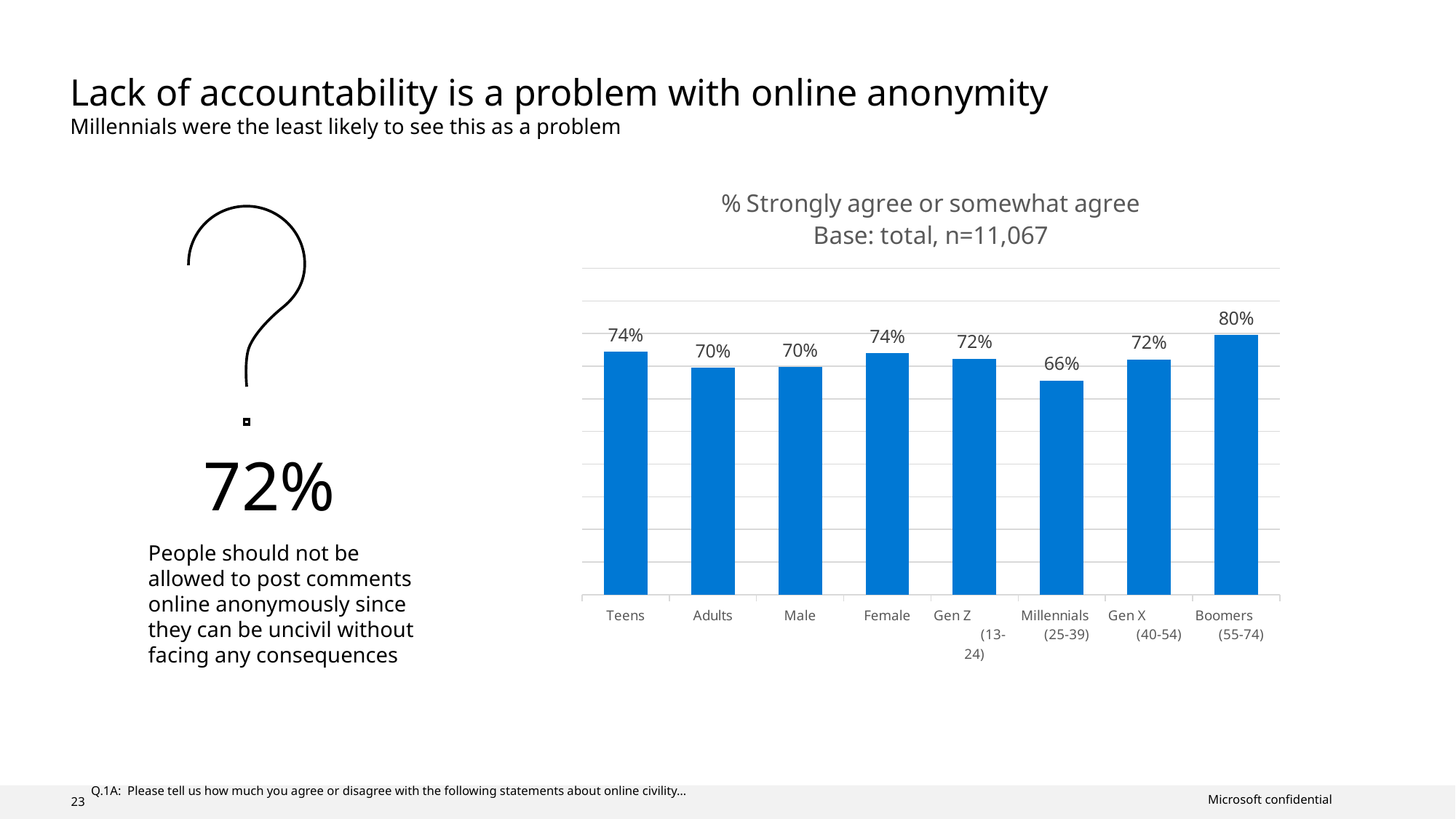
Which is larger, the value for Teens or the value for Adults? Teens How many categories are shown on the x axis of the chart? 8 What is the value for Millennials (25-39)? 66% What is the title of the chart? % Strongly agree or somewhat agree Base: total, n=11,067 What kind of chart is shown on the slide? Bar chart What is the value for Boomers (55-74)? 80% What is the value for Gen X (40-54)? 72% What is the difference between the values for Boomers (55-74) and Millennials (25-39)? 14% Which category has the lowest value? Millennials (25-39) What is the difference between the values for Female and Male? 4% Which category has the highest value? Boomers (55-74) What is the value for Teens? 74%